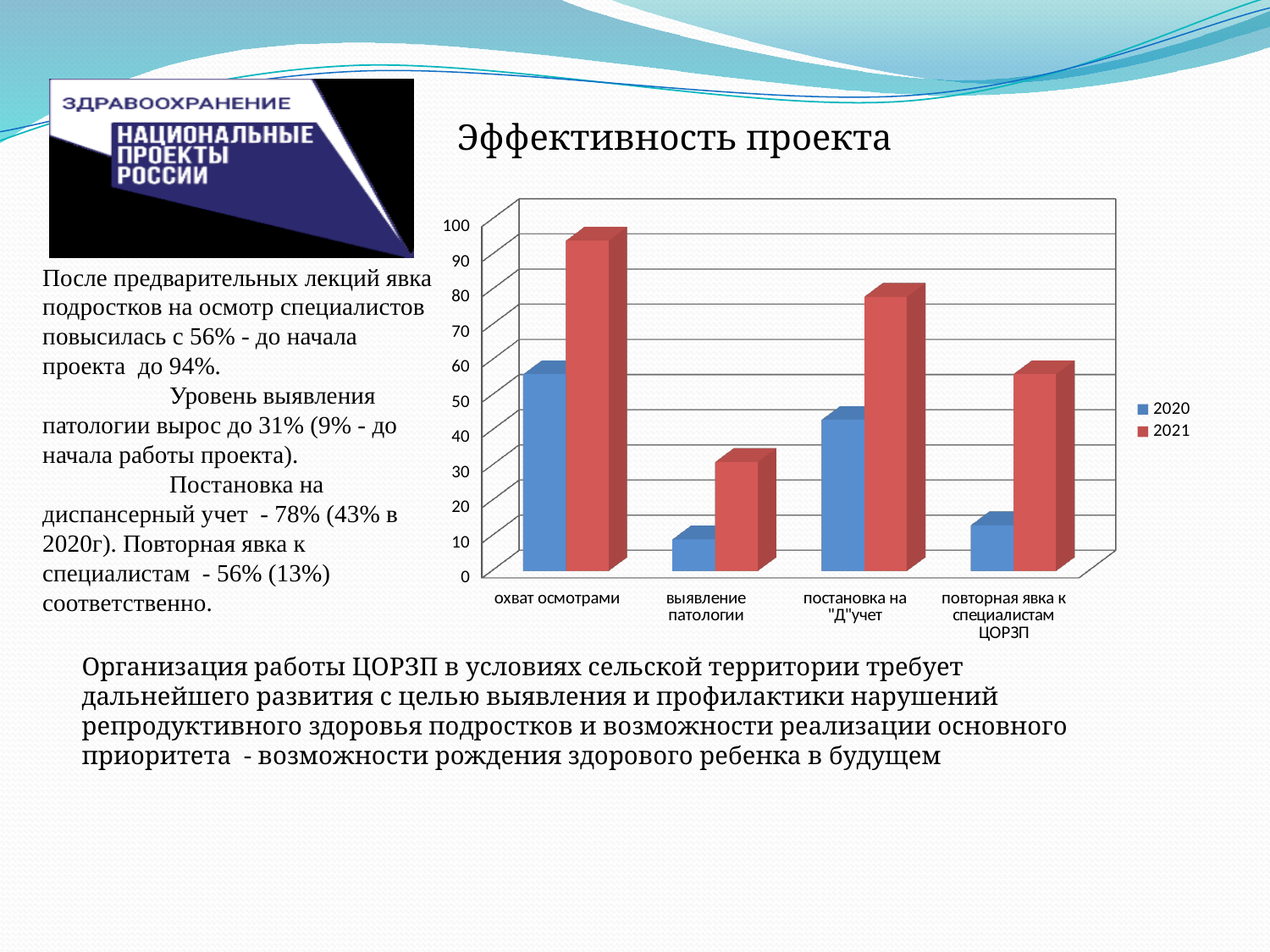
Which category has the highest value for the 2021 series? охват осмотрами For the category "постановка на "Д"учет", which series has the larger value, 2020 or 2021? 2021 What is the title of the chart on the slide? Эффективность проекта Is the 2020 value for "выявление патологии" greater or less than 20? less How many series does the chart legend list? 2 Is the 2020 value for "повторная явка к специалистам ЦОРЗП" greater or less than 20? less For the category "охват осмотрами", which series has the larger value, 2020 or 2021? 2021 Is the 2021 value for "постановка на "Д"учет" greater or less than 70? greater Which category has the lowest value for the 2020 series? выявление патологии What kind of chart is shown on the slide? bar chart How many categories are shown on the x axis of the chart? 4